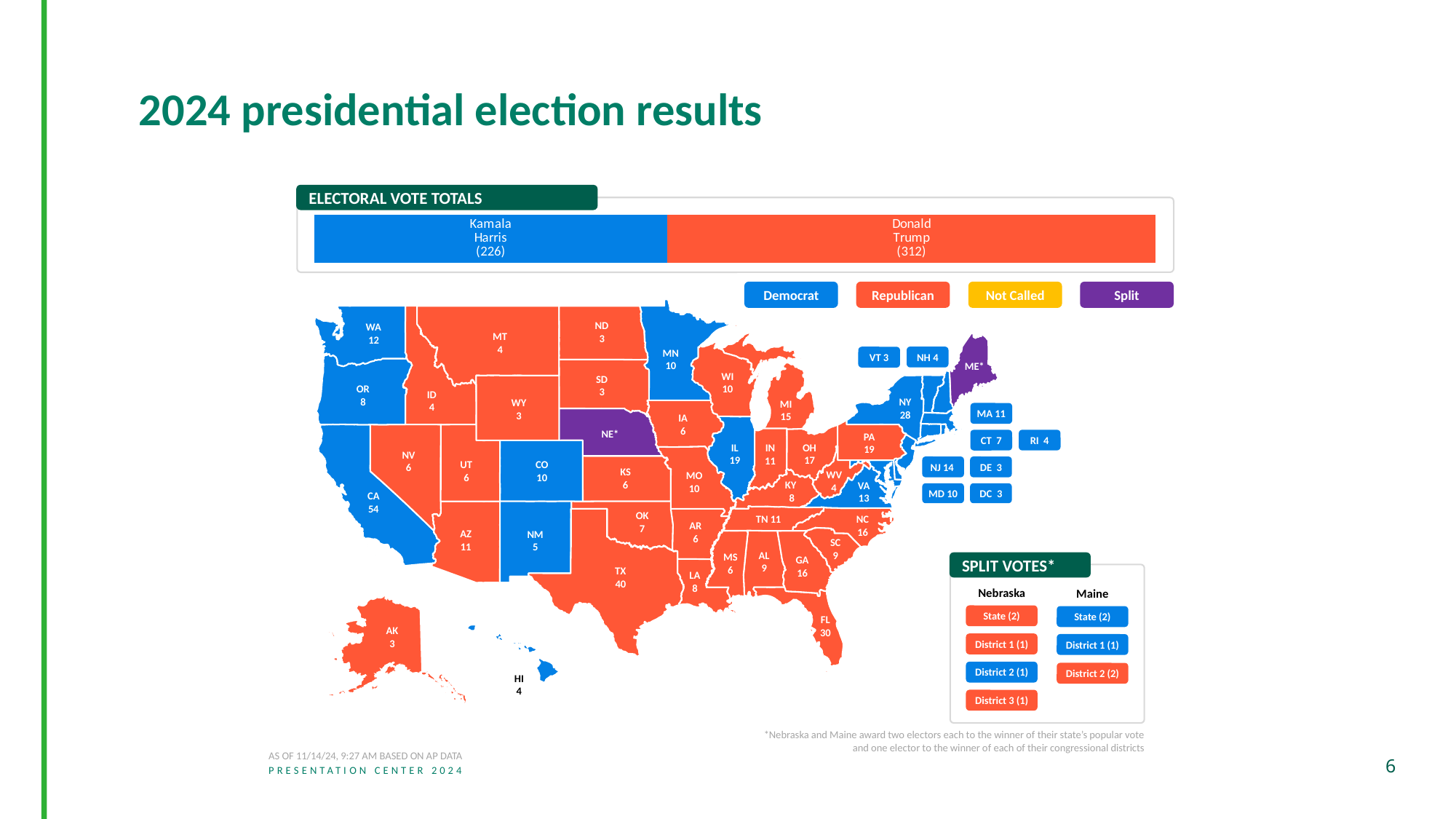
How many categories does the map legend list? 4 In the Electoral Vote Totals bar, what is the difference between Donald Trump's and Kamala Harris's electoral votes? 86 On the map, which state has the most electoral votes? CA In the Electoral Vote Totals bar, which candidate has more electoral votes? Donald Trump On the map, what is the difference in electoral votes between FL and PA? 11 In the Electoral Vote Totals bar, how many electoral votes does Kamala Harris have? 226 On the map, which colour represents Split states? Purple In the Electoral Vote Totals bar, what is the combined total of the two candidates' electoral votes? 538 On the map, how many electoral votes does CA have? 54 What kind of chart is the Electoral Vote Totals graphic? Stacked bar chart On the map, how many electoral votes does TX have? 40 In the Electoral Vote Totals bar, how many electoral votes does Donald Trump have? 312